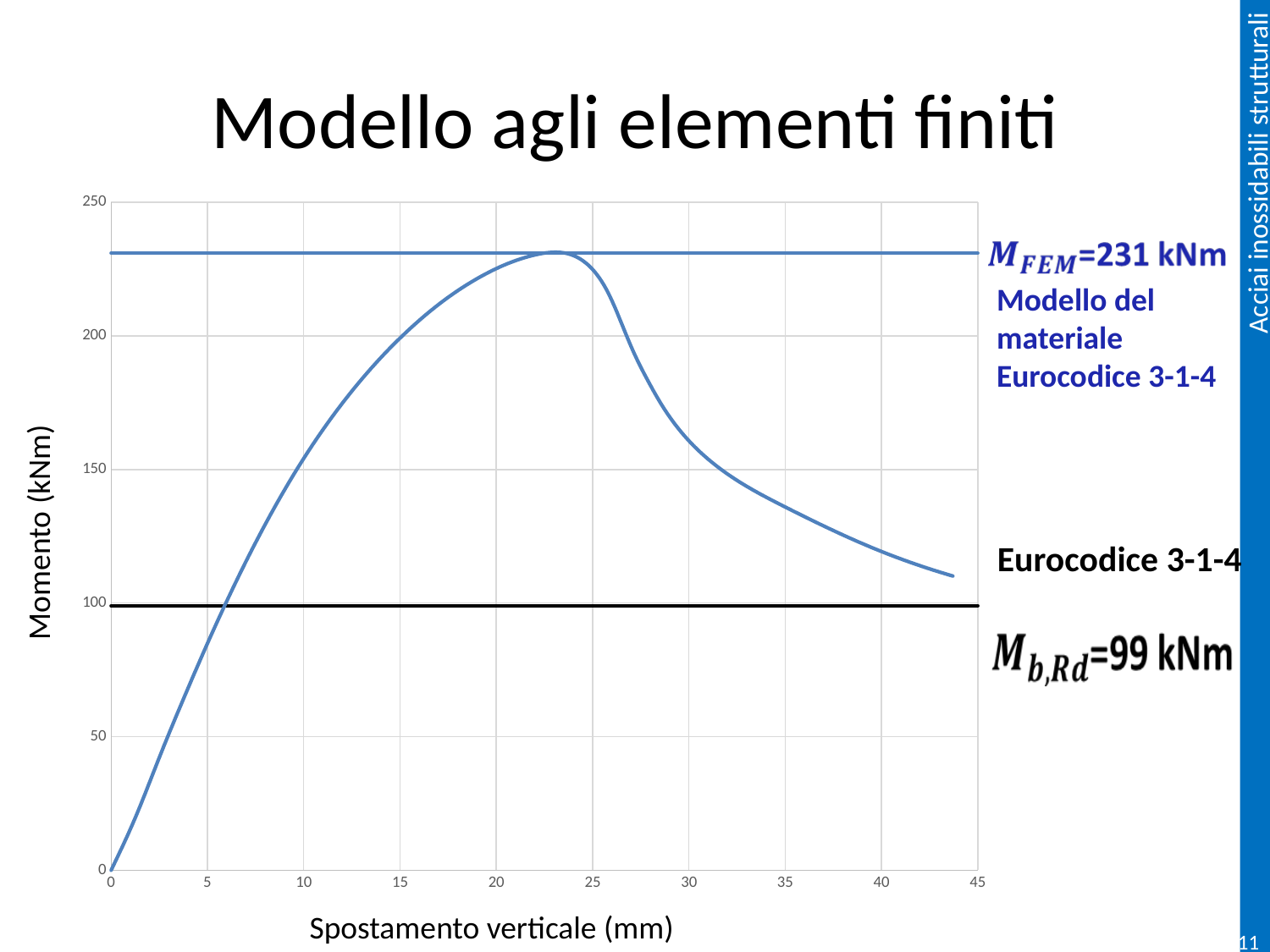
What is the value of M_FEM shown on the chart? 231 kNm What is the value of M_b,Rd shown on the chart? 99 kNm Which is larger, M_FEM or M_b,Rd? M_FEM What is the difference between M_FEM and M_b,Rd? 132 kNm What is the label of the horizontal axis? Spostamento verticale (mm) What is the label of the vertical axis? Momento (kNm) Does the moment rise or fall as the vertical displacement increases from 25 mm to 45 mm? fall What kind of chart is shown on the slide? line chart Is the moment at a vertical displacement of 20 mm greater or less than 200? greater Is the moment at a vertical displacement of 5 mm greater or less than 100? less Is the moment at a vertical displacement of 40 mm greater or less than 150? less What is the peak moment reached by the curve? 231 kNm